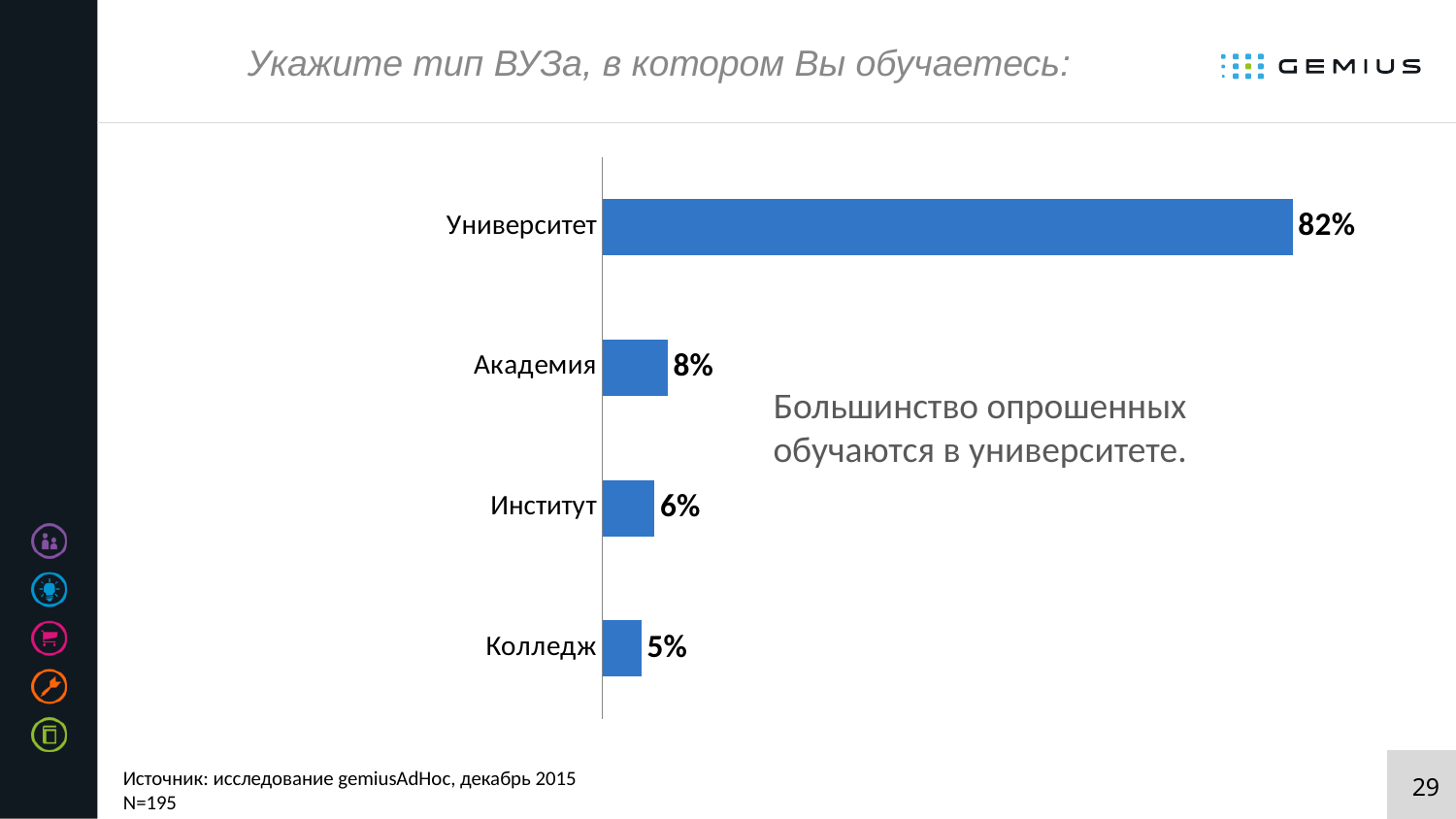
How many institution types are shown in the chart? 4 What is the difference in percentage points between Университет and Академия? 74 What is the sample size (N) stated on the slide? N=195 What is the value shown for Академия? 8% Which type of institution has the lowest share of respondents? Колледж Which type of institution has the highest share of respondents? Университет What is the value shown for Институт? 6% Which has a larger value, Академия or Институт? Академия What percentage of respondents study at a Университет? 82% What is the value shown for Колледж? 5% What kind of chart is shown on the slide? Bar chart What is the difference in percentage points between Институт and Колледж? 1